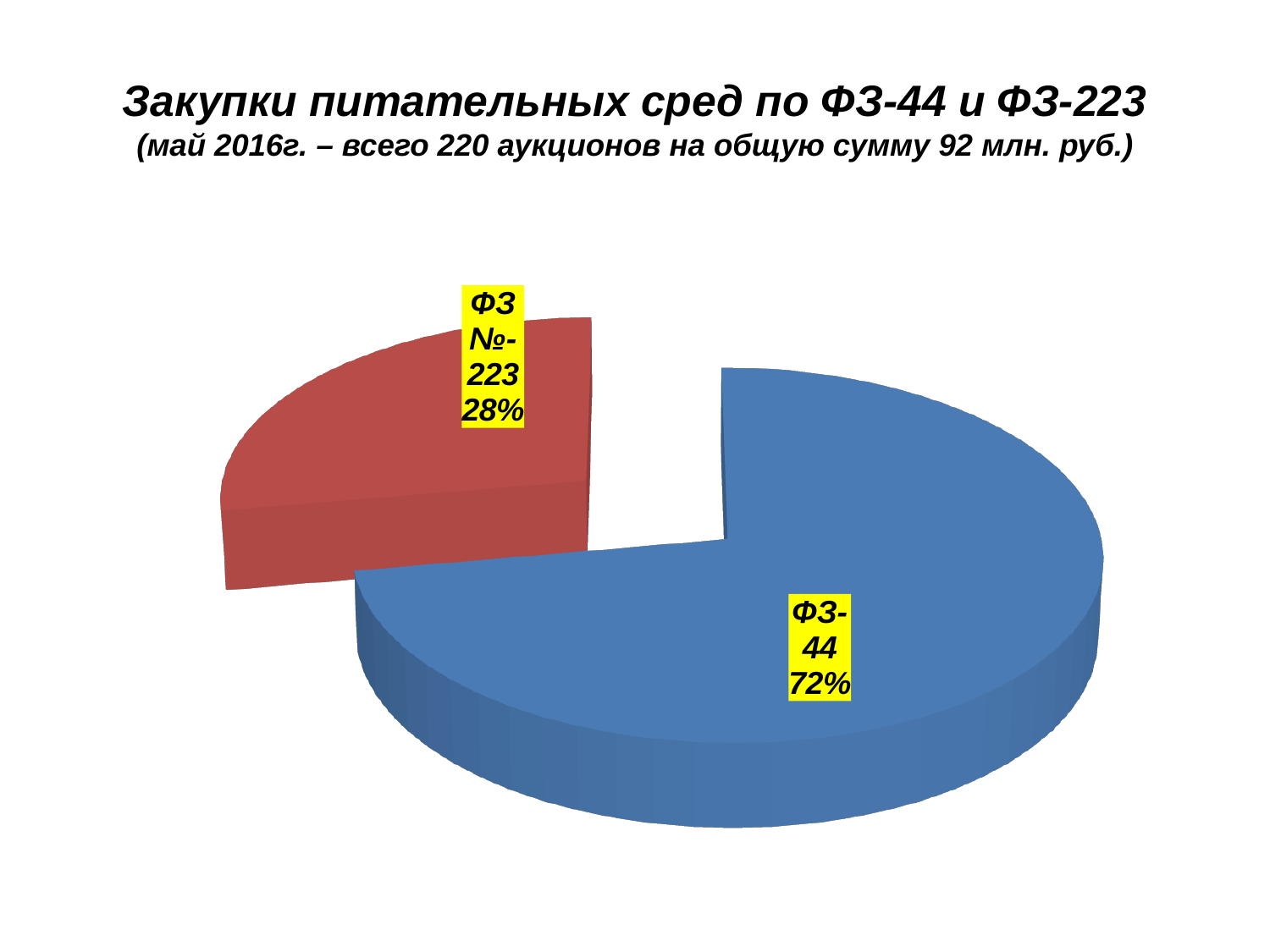
What kind of chart is shown on the slide? pie chart Is the share for ФЗ №-223 greater or less than 50%? less Which slice is the smallest? ФЗ №-223 What is the difference in percentage points between the ФЗ-44 and ФЗ №-223 slices? 44 What colour is the ФЗ №-223 slice? red Which is larger, the ФЗ-44 slice or the ФЗ №-223 slice? ФЗ-44 Which slice is the largest? ФЗ-44 What share of the pie does ФЗ-44 have? 72% How many slices does the pie chart have? 2 What colour is the ФЗ-44 slice? blue What share of the pie does ФЗ №-223 have? 28%